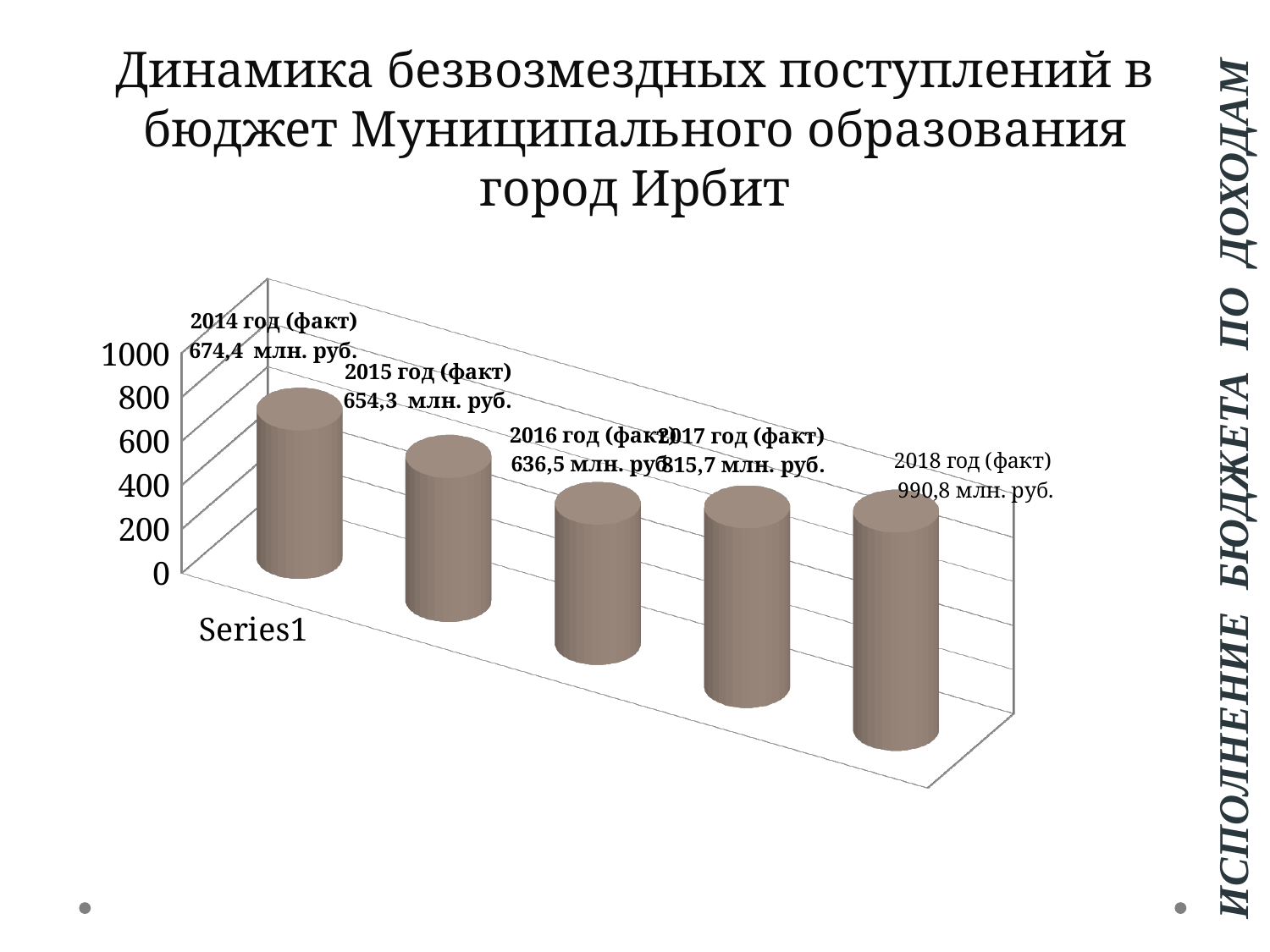
What is the value for 2014 год (факт)? 674,4 млн. руб. What is the value for 2018 год (факт)? 990,8 млн. руб. What kind of chart is this? bar chart What is the difference between the values for 2014 and 2015? 20,1 млн. руб. How many years are shown in the chart? 5 Which year has the highest value? 2018 год (факт) What is the value for 2016 год (факт)? 636,5 млн. руб. Which year has the lowest value? 2016 год (факт) What is the difference between the values for 2018 and 2017? 175,1 млн. руб. What is the title of the chart? Динамика безвозмездных поступлений в бюджет Муниципального образования город Ирбит Is the value for 2018 greater or less than 800? greater Which is larger, the value for 2017 or the value for 2014? 2017